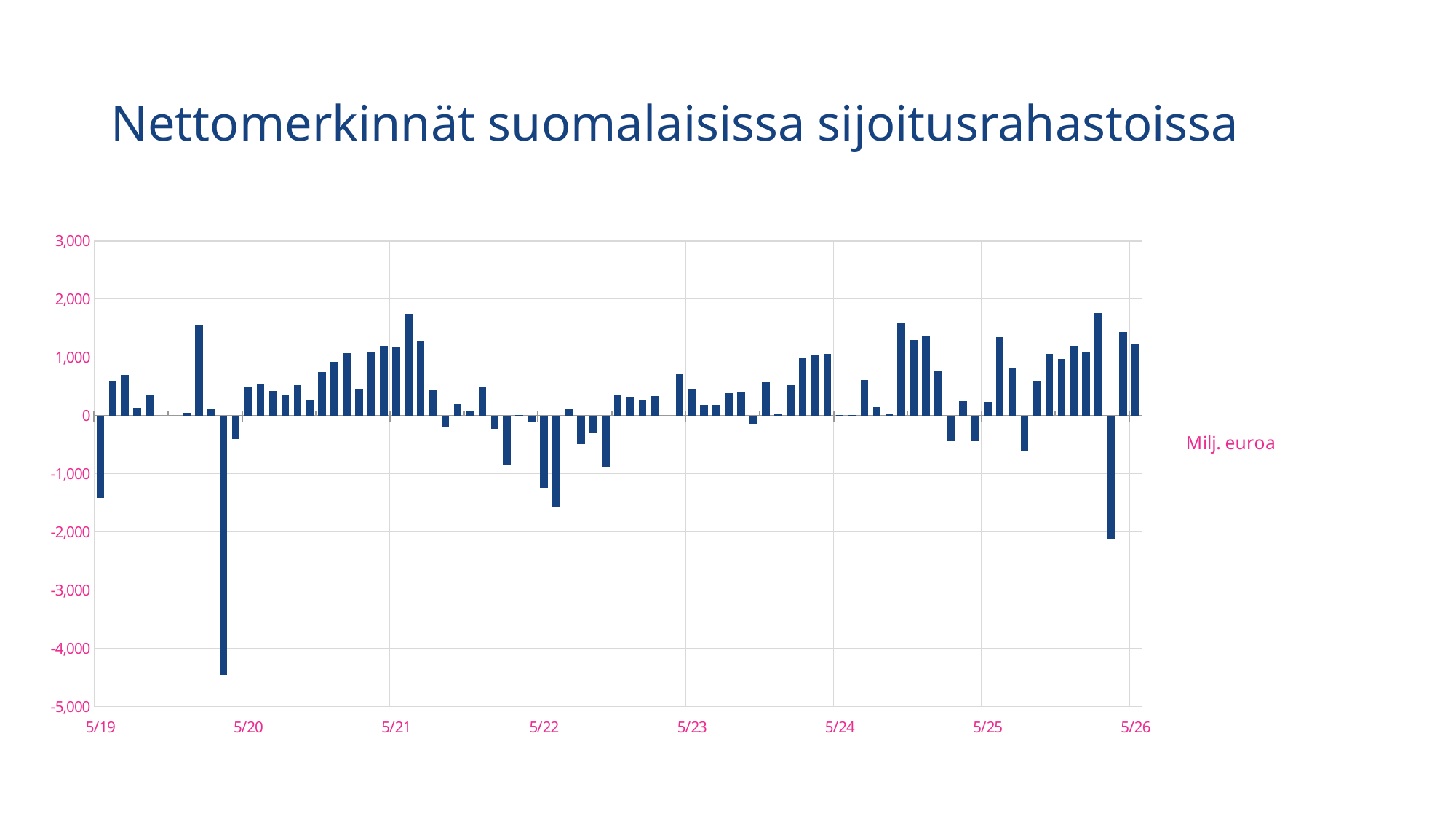
Is the value for 5/20 greater or less than 0? greater Is the value for 5/22 greater or less than -1,000? less Is the value for 5/26 greater or less than 1,000? greater What unit label is shown next to the chart? Milj. euroa Which is larger, the value for 5/21 or the value for 5/22? 5/21 What is the title of the chart? Nettomerkinnät suomalaisissa sijoitusrahastoissa How many date labels are shown on the x axis? 8 What kind of chart is shown on the slide? bar chart